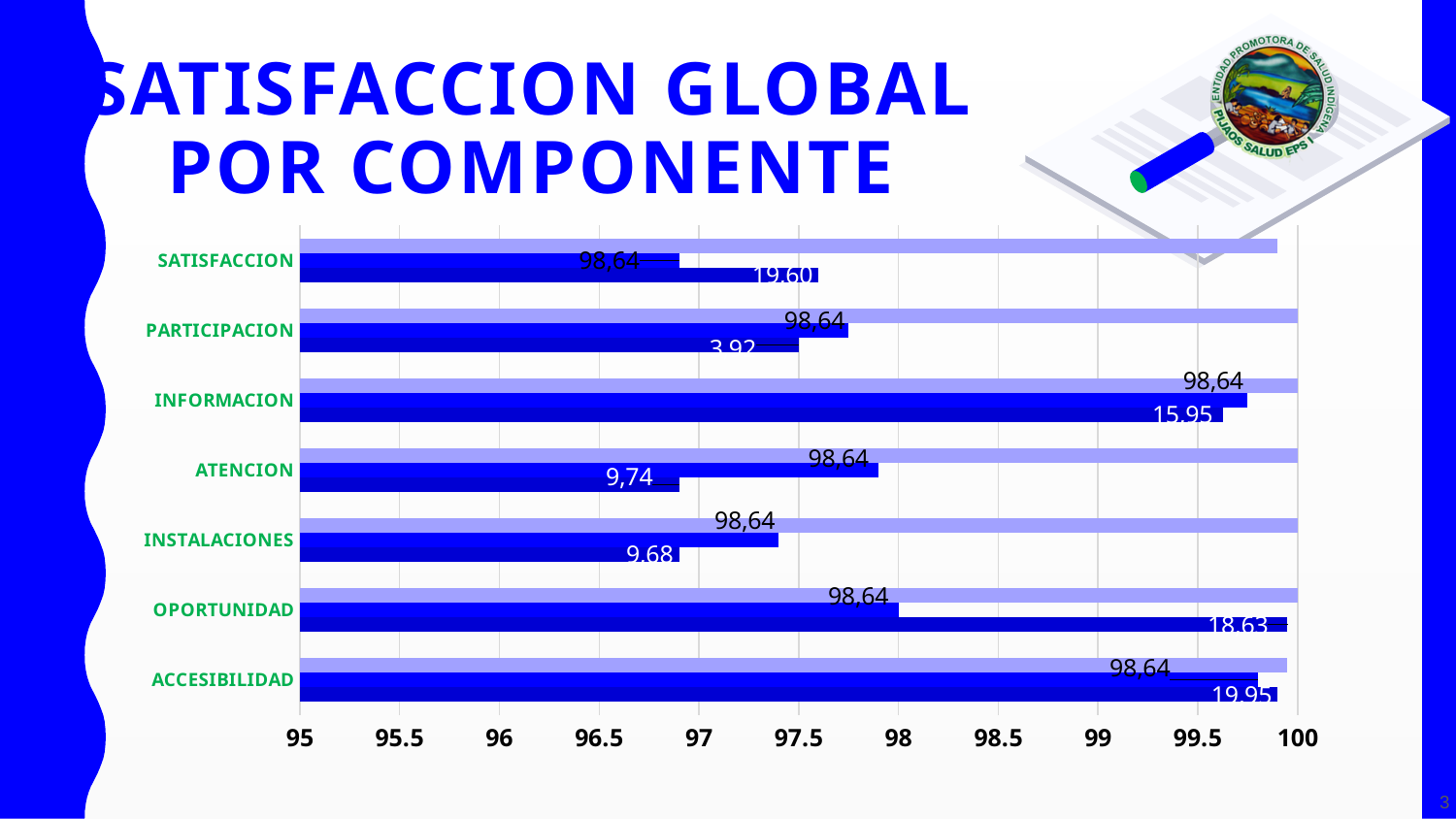
How many bars are plotted for each category in the chart? 3 How many categories are listed on the vertical axis of the chart? 7 What data label is printed on the dark blue bar for ATENCION? 9,74 Is the dark blue bar for SATISFACCION greater or less than 98? less Is the dark blue bar for INFORMACION greater or less than 99? greater What data label is printed on the light blue bar for INFORMACION? 98,64 What is the title of the slide containing the chart? SATISFACCION GLOBAL POR COMPONENTE What kind of chart is shown on the slide? bar chart Which has the longer dark blue bar, INFORMACION or ATENCION? INFORMACION What data label is printed on the dark blue bar for INSTALACIONES? 9,68